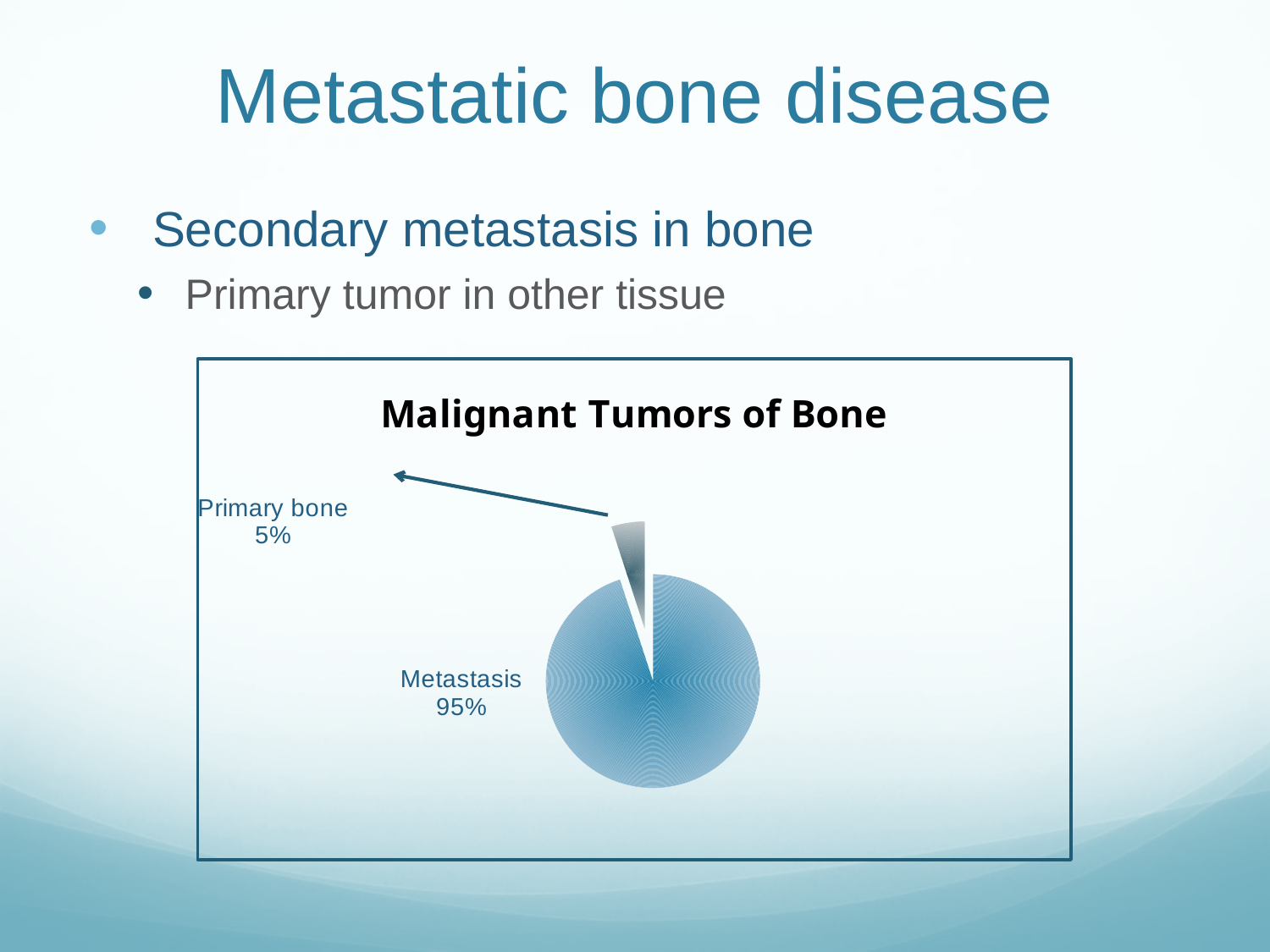
Which slice of the pie is the smallest? Primary bone How many slices does the pie chart have? 2 What percentage of the pie is labelled Metastasis? 95% What is the difference in percentage points between the Metastasis and Primary bone slices? 90 Which is larger, the Metastasis slice or the Primary bone slice? Metastasis What percentage of the pie is labelled Primary bone? 5% Is the Metastasis slice greater or less than 50% of the pie? greater What is the title of the chart? Malignant Tumors of Bone Which slice of the pie is the largest? Metastasis What type of chart is shown on the slide? Pie chart What share of the pie does the Primary bone slice represent? 5%